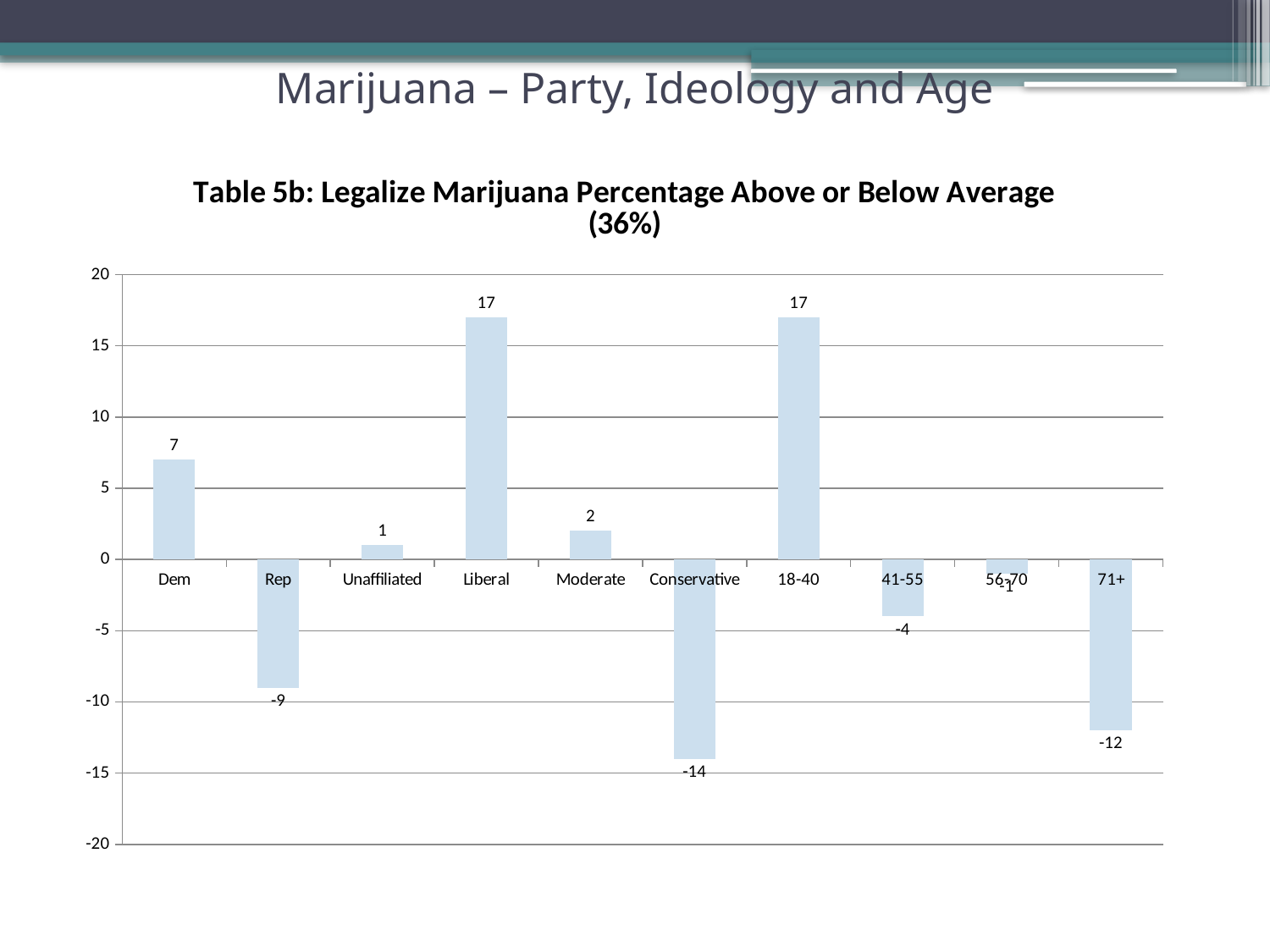
What is the value for Dem? 7 How many categories are shown on the x axis? 10 What is the value for 71+? -12 What is the difference between the values for Liberal and Moderate? 15 Which is larger, the value for Unaffiliated or the value for Moderate? Moderate What is the difference between the values for Dem and Rep? 16 Which is larger, the value for 41-55 or the value for 71+? 41-55 What kind of chart is shown on the slide? Bar chart Which category has the lowest value? Conservative What is the value for Rep? -9 What is the title of the chart? Table 5b: Legalize Marijuana Percentage Above or Below Average (36%) What is the value for Conservative? -14